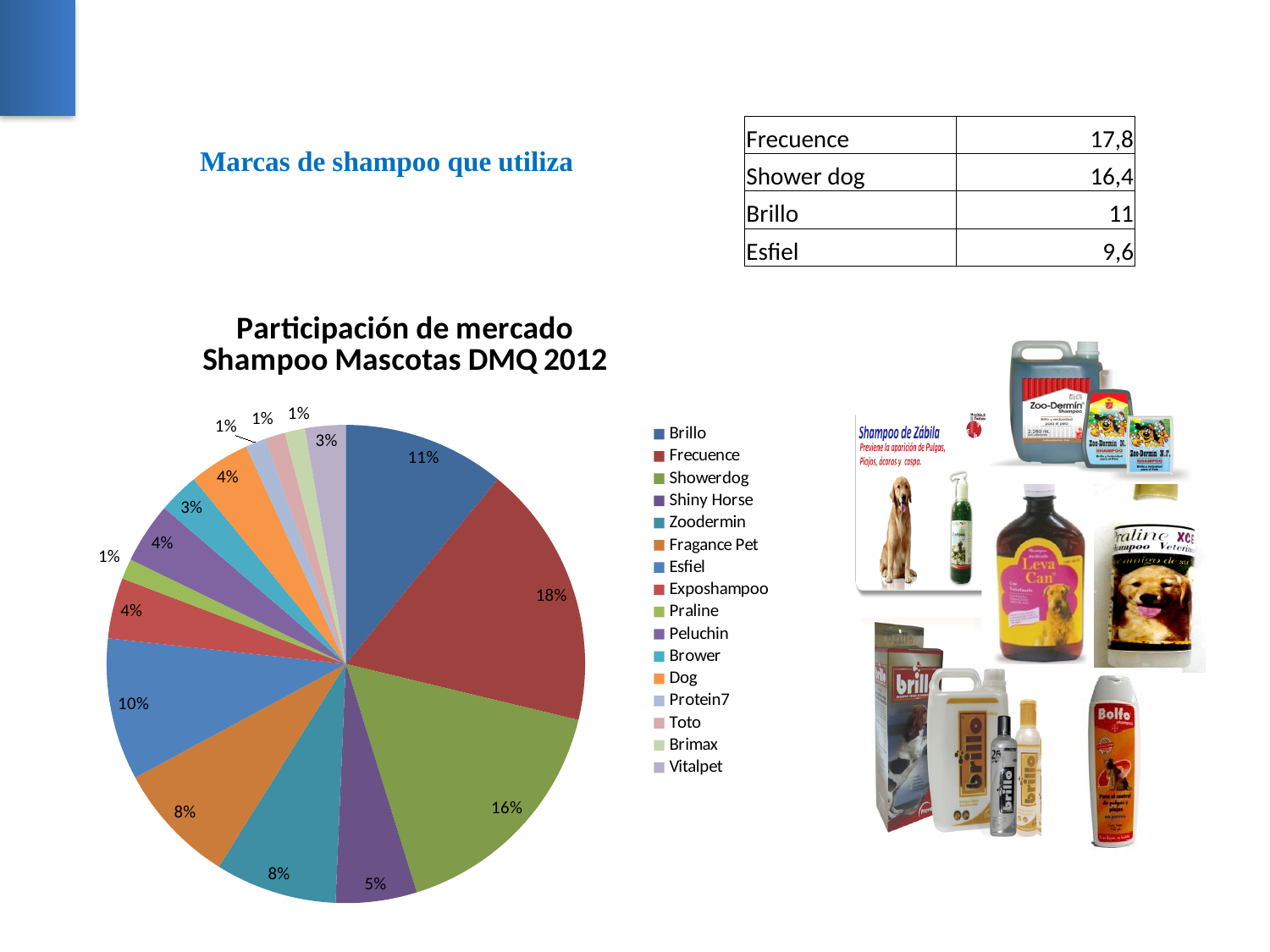
What is the value shown for Showerdog in the pie chart? 16% What is the title of the pie chart? Participación de mercado Shampoo Mascotas DMQ 2012 What share of the market does Frecuence hold in the pie chart? 18% In the pie chart, which is larger, the slice for Esfiel or the slice for Shiny Horse? Esfiel What kind of chart is shown under the title "Participación de mercado Shampoo Mascotas DMQ 2012"? Pie chart How many brands does the legend of the pie chart list? 16 What is the value shown for Esfiel in the pie chart? 10% Which brand has the largest slice in the pie chart? Frecuence In the pie chart, what is the difference in percentage points between Brillo and Esfiel? 1 What is the value shown for Brillo in the pie chart? 11% In the pie chart, what is the difference in percentage points between Frecuence and Showerdog? 2 What is the value shown for Shiny Horse in the pie chart? 5%